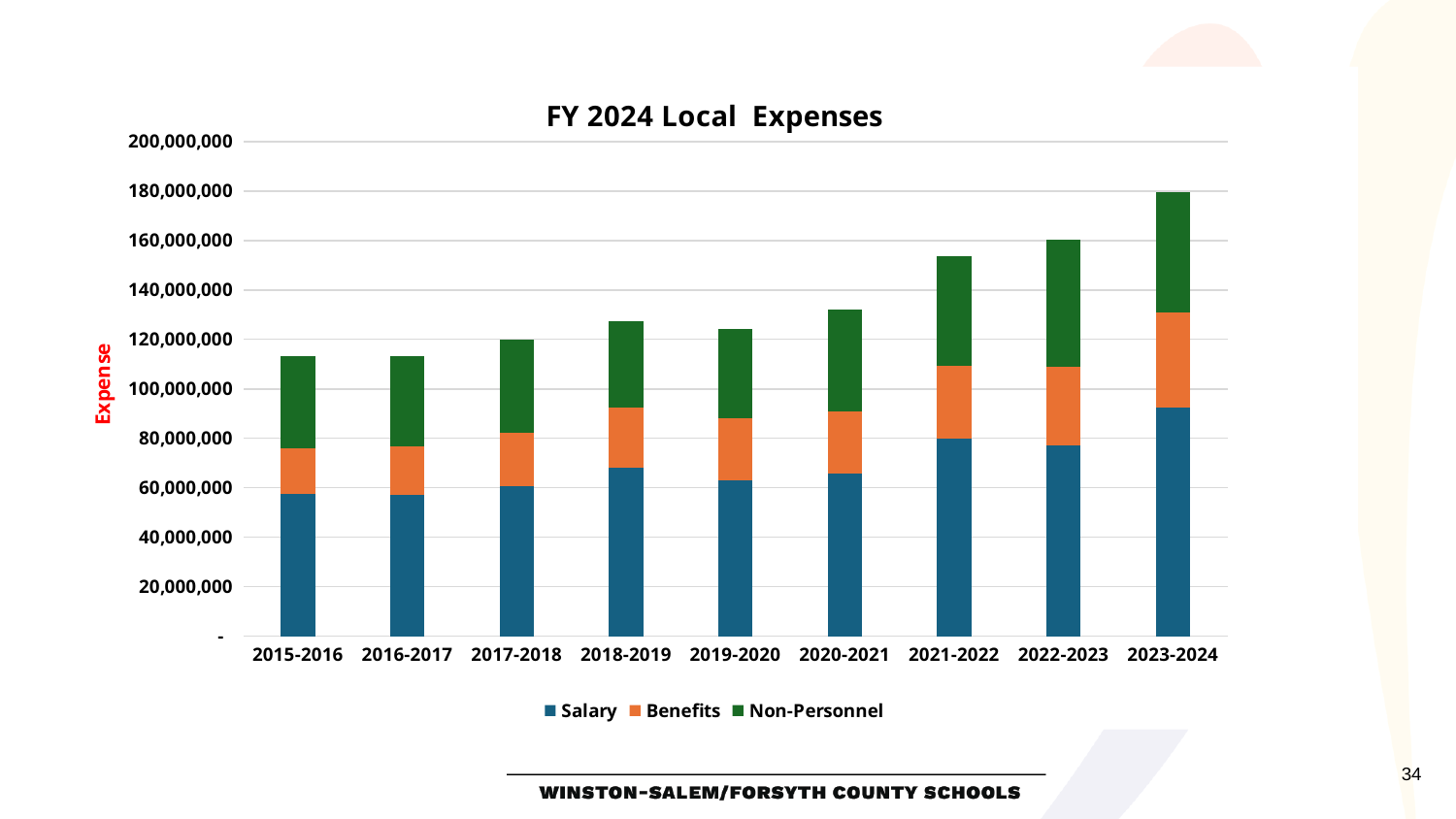
What kind of chart is shown on the slide? Stacked bar chart Which series are listed in the legend? Salary, Benefits, Non-Personnel Which fiscal year has the highest total expense? 2023-2024 Do total expenses generally rise or fall from 2015-2016 to 2023-2024? rise Is the Salary value for 2023-2024 greater or less than 80,000,000? greater What is the title of the chart? FY 2024 Local Expenses Which has the larger total expense, 2020-2021 or 2021-2022? 2021-2022 Is the total expense for 2015-2016 greater or less than 120,000,000? less Which fiscal year has the largest Salary segment? 2023-2024 Is the total expense for 2023-2024 greater or less than 160,000,000? greater How many series does the legend list? 3 How many fiscal years are shown on the x axis? 9